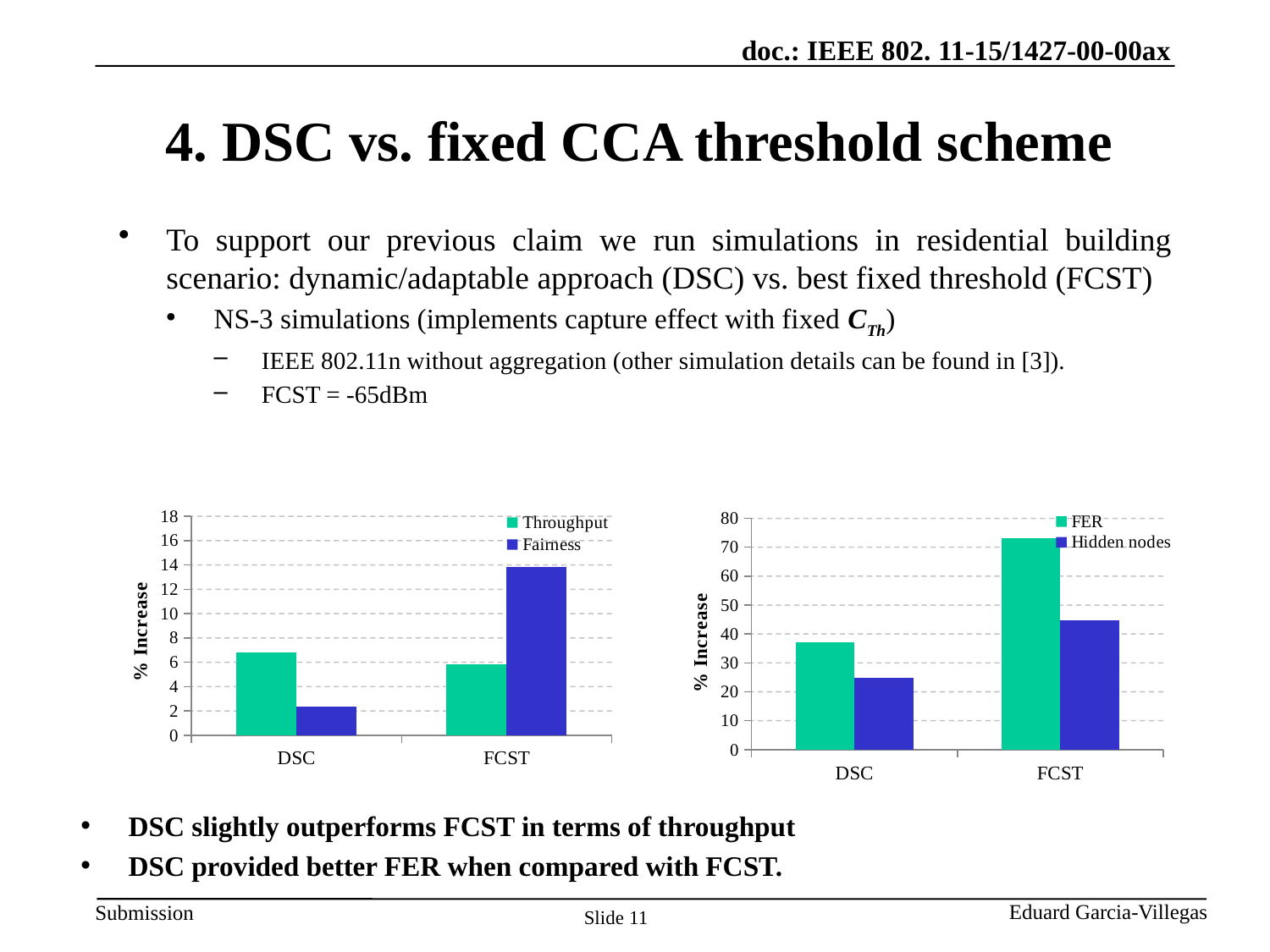
What is the y-axis title of the right chart? % Increase In the left chart, which bar is the tallest overall? Fairness for FCST What kind of chart is the left chart on the slide? bar chart How many categories are shown on the x axis of the right chart? 2 In the right chart, is the FER value for FCST greater or less than 70? greater In the right chart, which category has the higher FER value, DSC or FCST? FCST In the right chart, is the Hidden nodes value for DSC greater or less than 30? less What are the two series named in the legend of the right chart? FER and Hidden nodes In the left chart, is the Fairness value for DSC greater or less than 4? less How many series does the legend of the left chart list? 2 In the left chart, which category has the higher Throughput value, DSC or FCST? DSC